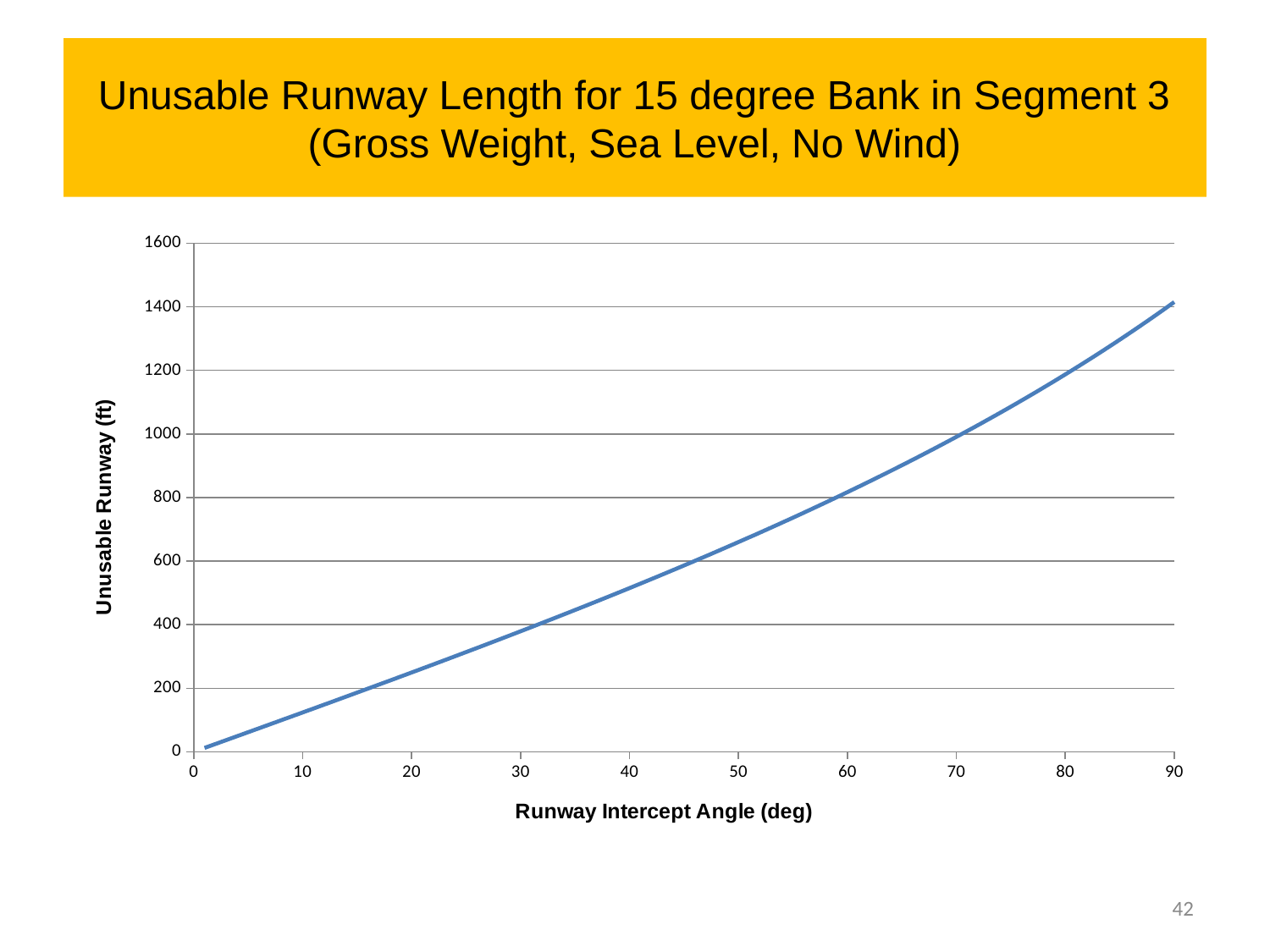
What is the label of the y axis? Unusable Runway (ft) Is the unusable runway length at a 60 degree intercept angle greater or less than 600 ft? greater What kind of chart is shown on the slide? line chart At which runway intercept angle is the unusable runway length highest? 90 deg What is the label of the x axis? Runway Intercept Angle (deg) Is the unusable runway length at a 30 degree intercept angle greater or less than 600 ft? less Is the unusable runway length at a 90 degree intercept angle greater or less than 1200 ft? greater Which is larger, the unusable runway length at 40 degrees or at 80 degrees? 80 degrees At which end of the x axis is the unusable runway length lowest? 0 deg Does the unusable runway length rise or fall as the runway intercept angle increases? rises